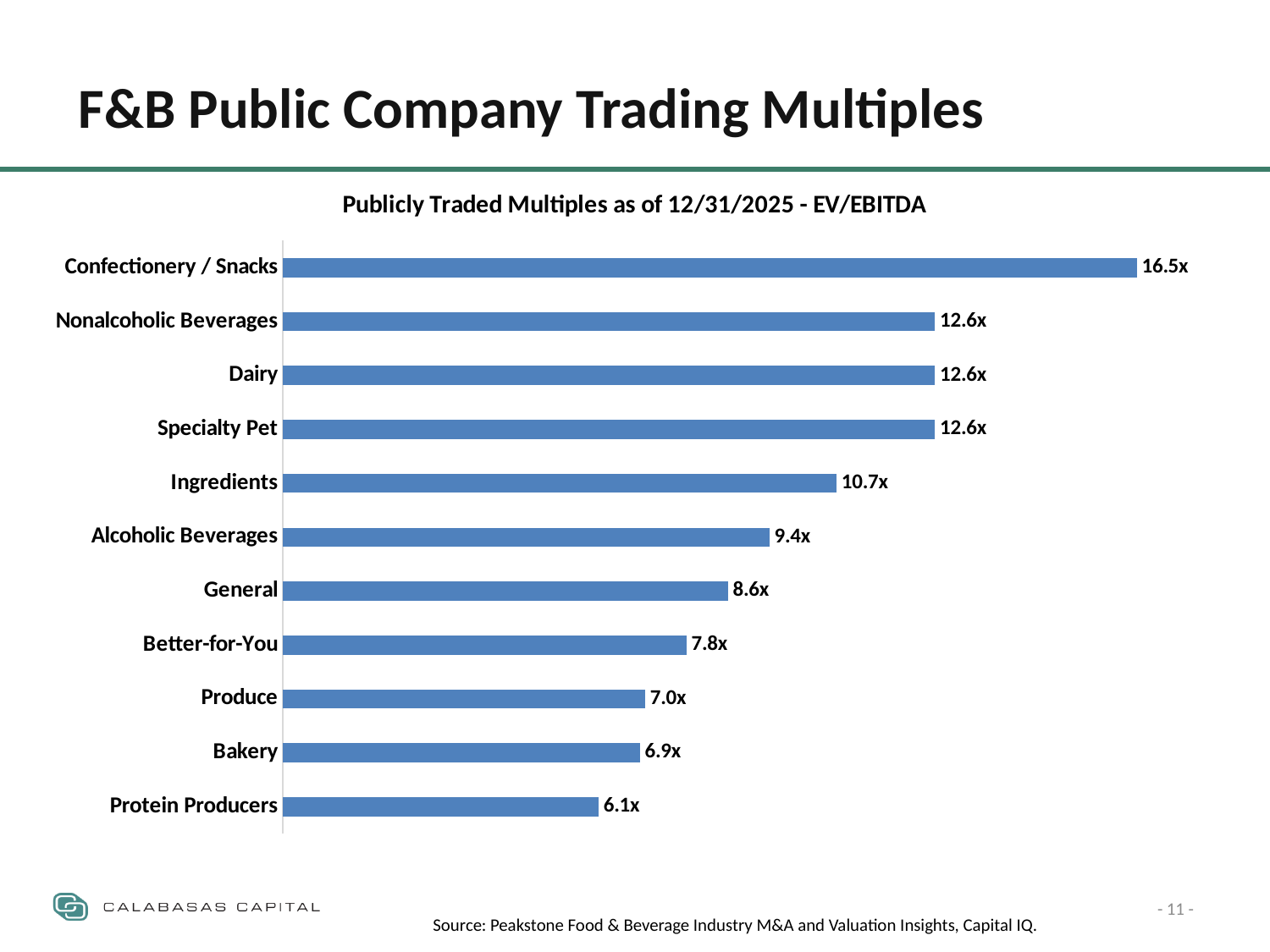
What is the difference between the multiples for Ingredients and Alcoholic Beverages? 1.3x What is the EV/EBITDA multiple for Confectionery / Snacks? 16.5x What is the difference between the multiples for Confectionery / Snacks and Protein Producers? 10.4x What is the EV/EBITDA multiple for Ingredients? 10.7x Which category has the lowest EV/EBITDA multiple? Protein Producers What is the title of the chart? Publicly Traded Multiples as of 12/31/2025 - EV/EBITDA Which category has the highest EV/EBITDA multiple? Confectionery / Snacks Which has a higher EV/EBITDA multiple, General or Better-for-You? General What is the EV/EBITDA multiple for Bakery? 6.9x Which has a higher EV/EBITDA multiple, Produce or Alcoholic Beverages? Alcoholic Beverages What kind of chart is shown on the slide? Bar chart How many categories are shown in the chart? 11